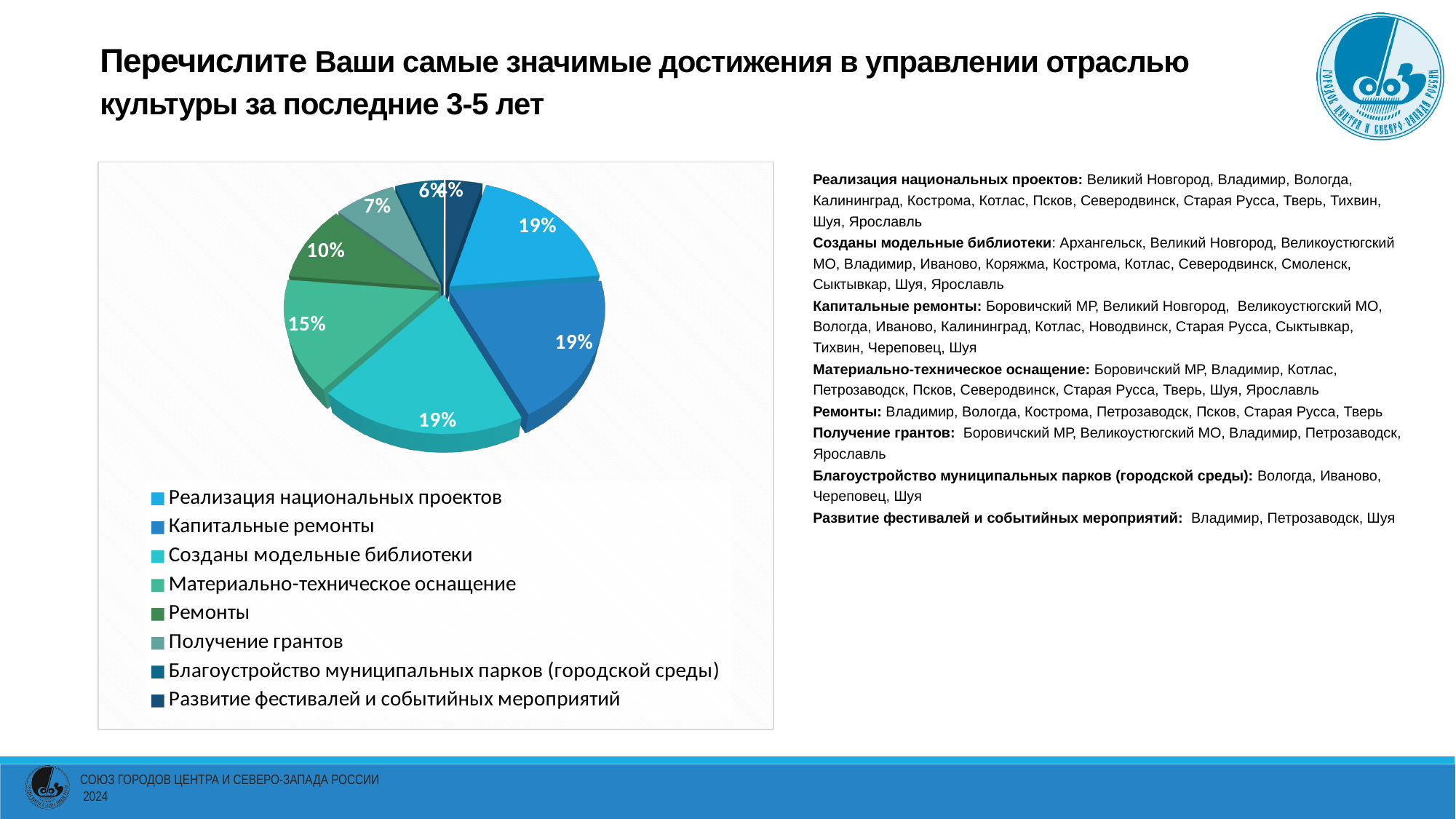
How many categories (slices) does the pie chart have? 8 What kind of chart is shown on the slide? Pie chart Which is larger: the slice for "Ремонты" or the slice for "Получение грантов"? Ремонты What is the value shown for "Материально-техническое оснащение"? 15% What share of the pie does "Ремонты" have? 10% What share of the pie does "Капитальные ремонты" have? 19% How many entries does the legend of the pie chart list? 8 What is the difference in percentage points between "Реализация национальных проектов" and "Получение грантов"? 12 percentage points What is the value shown for "Получение грантов"? 7% Which category has the smallest slice in the pie chart? Развитие фестивалей и событийных мероприятий What is the value shown for "Благоустройство муниципальных парков (городской среды)"? 6% What is the difference in percentage points between "Материально-техническое оснащение" and "Ремонты"? 5 percentage points